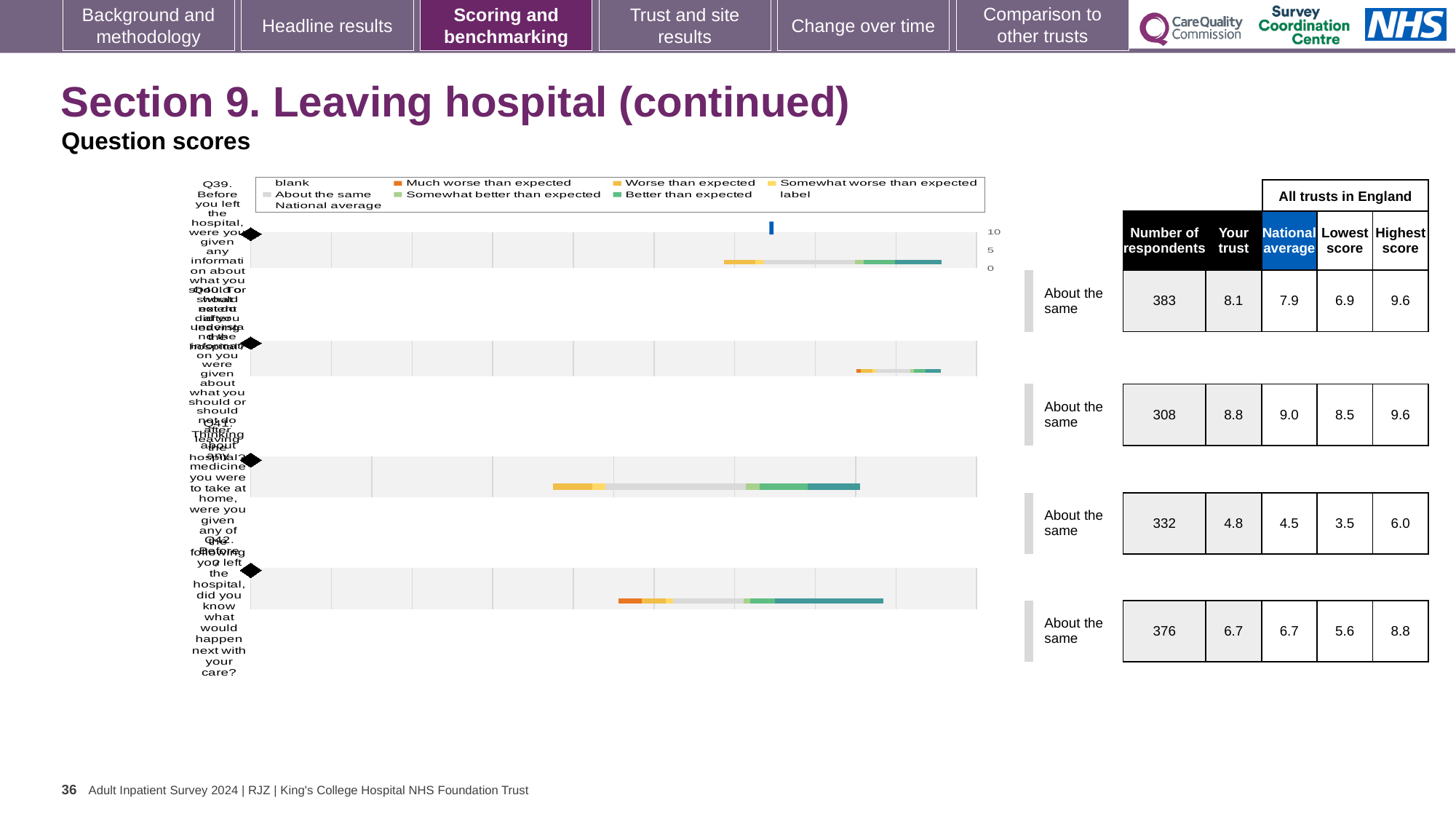
For Q39 (the first row), what is the difference between the 'Your trust' score and the national average? 0.2 In the table beside the chart, what is the highest score for Q39 (the first row)? 9.6 In the table beside the chart, what is the 'Your trust' score for Q42 (the last row)? 6.7 In the third row of the table, which is larger: the 'Your trust' score or the national average? Your trust In the table beside the chart, what is the 'Your trust' score for Q39 (the first row)? 8.1 Which row of the table has the lowest 'Your trust' score? the third row (4.8) In the table beside the chart, what is the lowest score for Q42 (the last row)? 5.6 What kind of chart is shown on the slide? bar chart What is the benchmark label shown next to the bar for Q39? About the same How many questions (bars) are plotted in the chart? 4 Which row of the table has the highest 'Your trust' score? the second row (8.8) In the table beside the chart, what is the number of respondents for Q39 (the first row)? 383